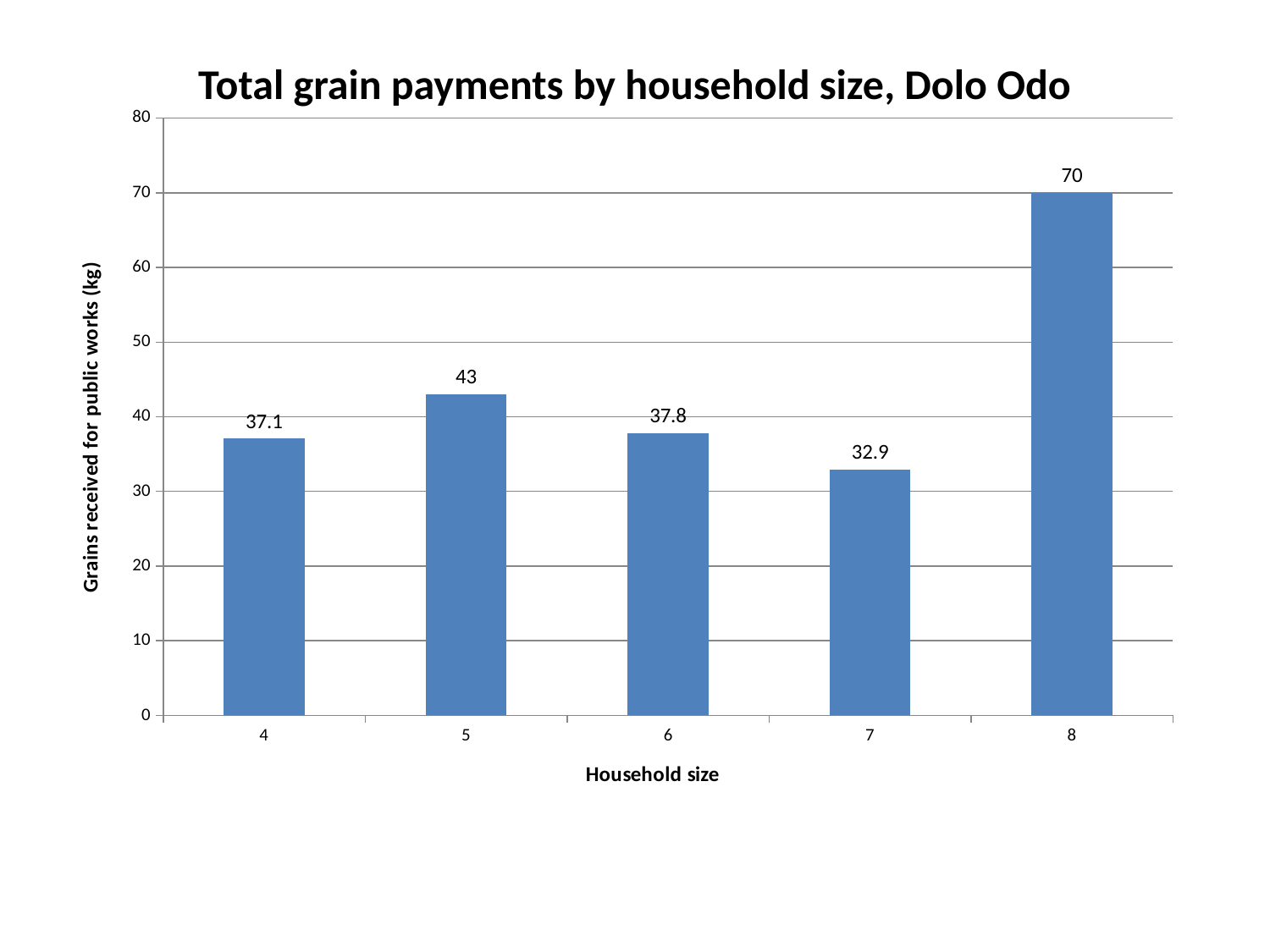
What is the difference between the values for household size 6 and household size 4? 0.7 What is the value for household size 8? 70 Which is larger, the value for household size 5 or household size 6? household size 5 What kind of chart is shown on the slide? bar chart Which household size has the highest grain payment? 8 How many household size categories are shown in the chart? 5 What is the value for household size 4? 37.1 What is the difference between the values for household size 8 and household size 5? 27 Which household size has the lowest grain payment? 7 What is the value for household size 7? 32.9 Is the value for household size 8 greater or less than 60? greater What is the title of the chart? Total grain payments by household size, Dolo Odo